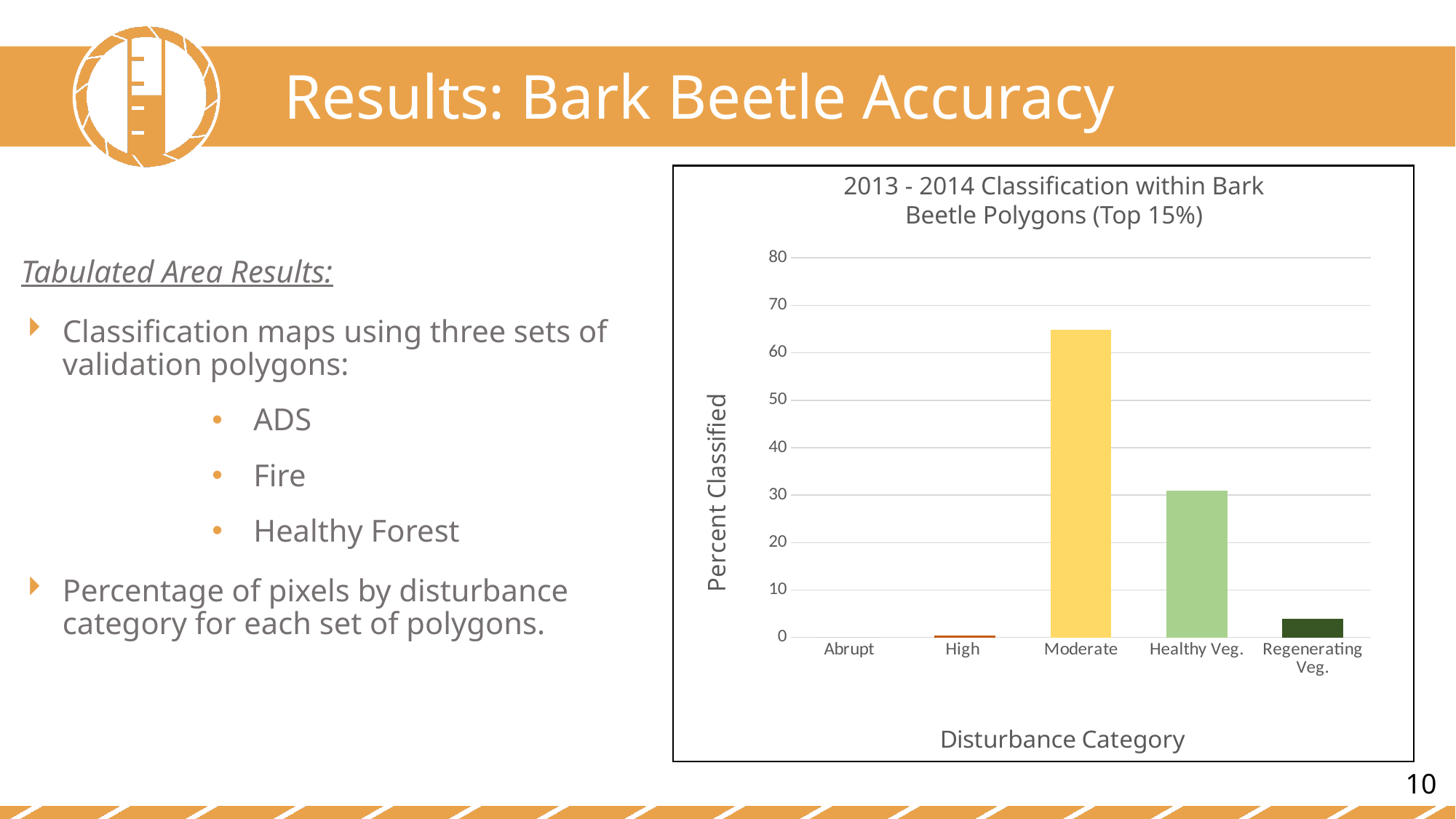
Is the value for Regenerating Veg. greater or less than 10? less Which disturbance category has the highest percent classified? Moderate Is the value for Healthy Veg. greater or less than 40? less Which is larger, the value for Healthy Veg. or the value for Regenerating Veg.? Healthy Veg. What is the title of the chart? 2013 - 2014 Classification within Bark Beetle Polygons (Top 15%) Is the value for Moderate greater or less than 70? less What kind of chart is shown on the slide? bar chart Which is larger, the value for Moderate or the value for Healthy Veg.? Moderate What is the label of the y axis of the chart? Percent Classified How many disturbance categories are shown on the x axis of the chart? 5